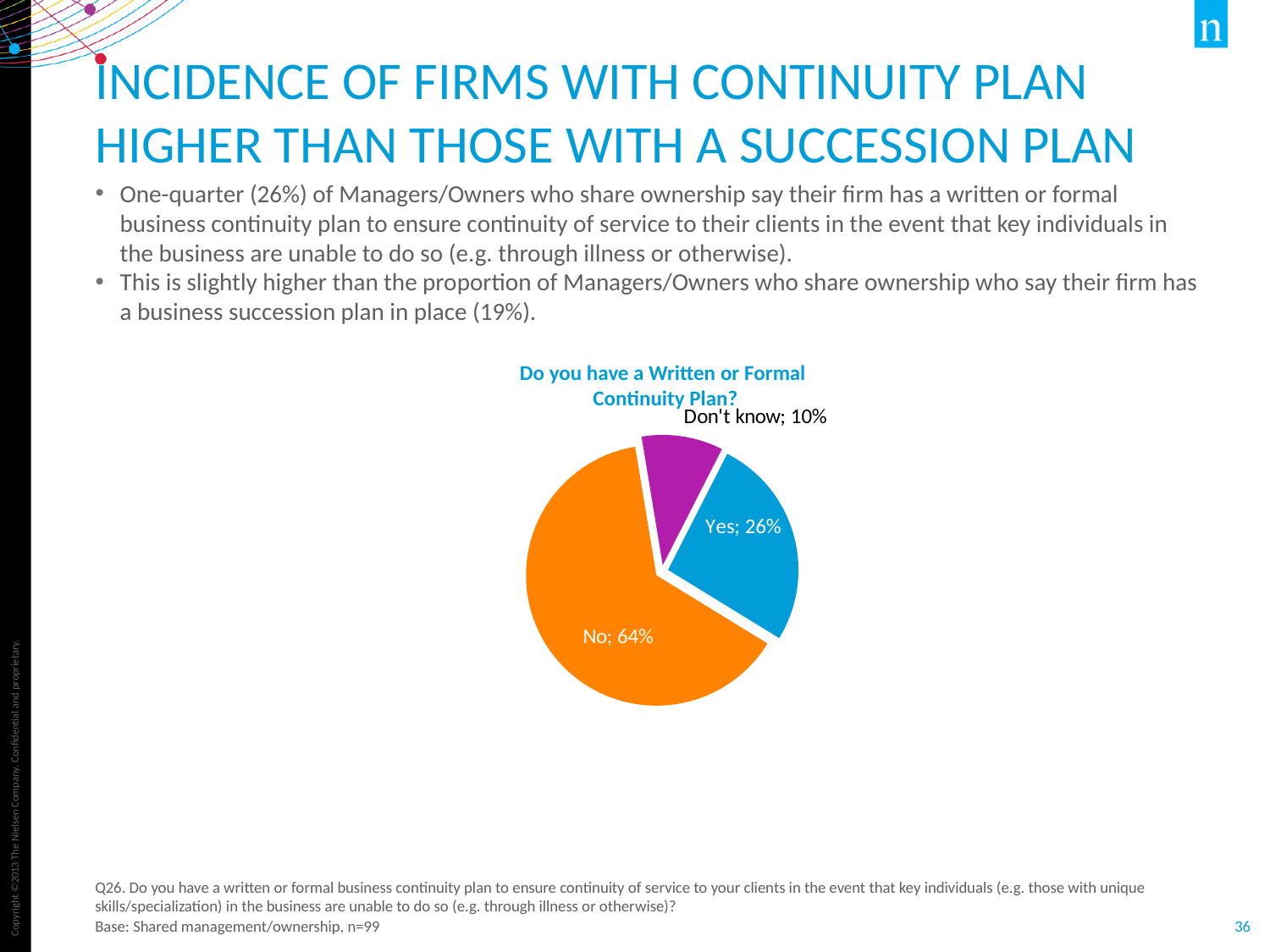
Which response has the largest slice of the pie? No What share of the pie does the "No" slice represent? 64% Which response has the smallest slice of the pie? Don't know How many slices does the pie chart have? 3 What percentage of respondents answered "Yes"? 26% What kind of chart is shown on the slide? pie chart What percentage of respondents answered "Don't know"? 10% Which is larger, the "Yes" slice or the "Don't know" slice? Yes What is the difference in percentage points between the "No" and "Yes" slices? 38 What is the chart's title? Do you have a Written or Formal Continuity Plan? What colour is the "Yes" slice? blue What percentage of respondents answered "No"? 64%